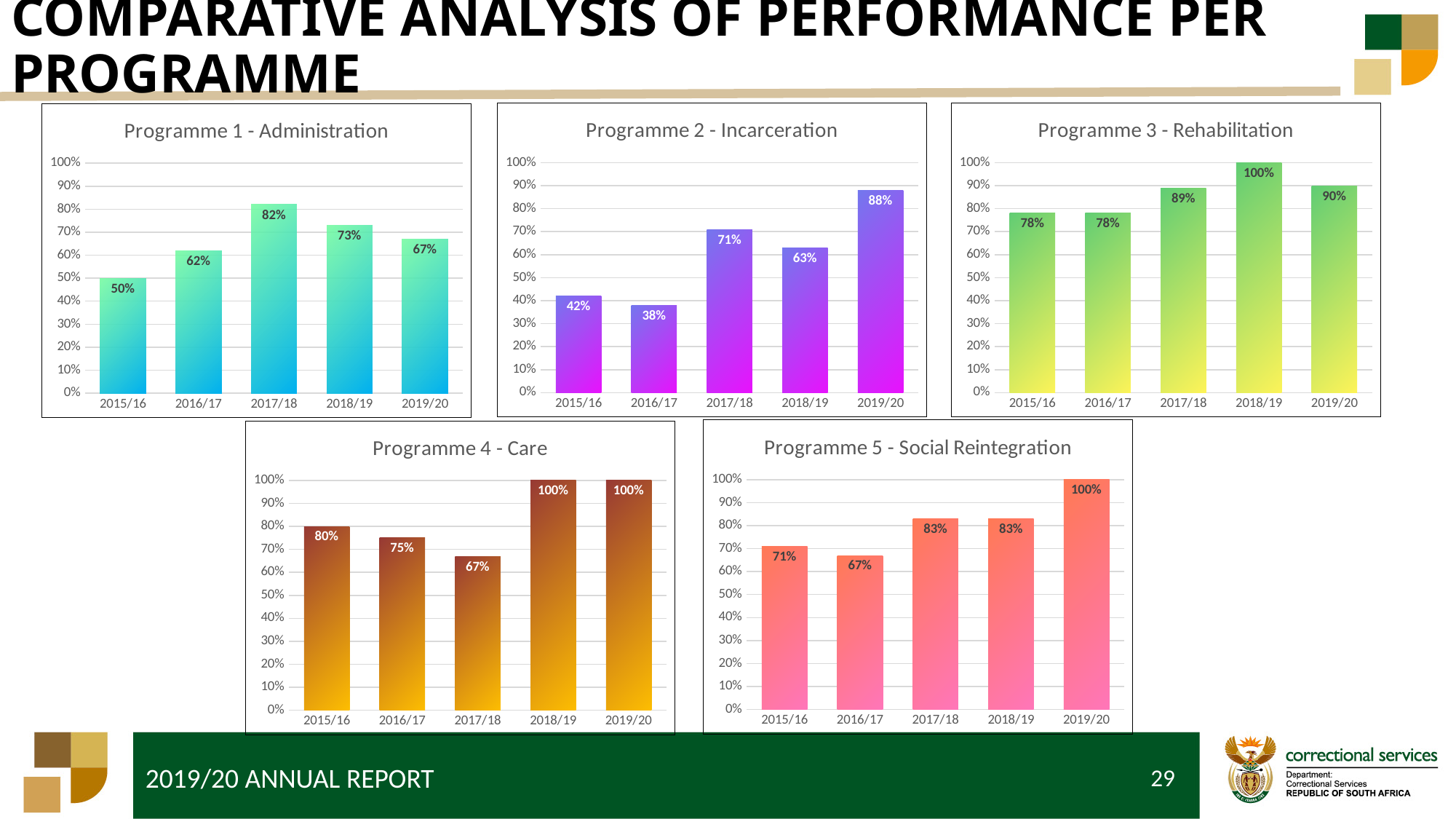
How many bars are in the Programme 1 - Administration chart? 5 In the Programme 4 - Care chart, which is larger, the value for 2015/16 or the value for 2017/18? 2015/16 In the Programme 5 - Social Reintegration chart, what is the difference between the 2019/20 and 2016/17 values? 33% In the Programme 2 - Incarceration chart, which year has the lowest value? 2016/17 What type of chart is the Programme 5 - Social Reintegration chart? Bar chart In the Programme 5 - Social Reintegration chart, what is the value for 2017/18? 83% How many charts are shown on the slide? 5 In the Programme 3 - Rehabilitation chart, what is the value for 2019/20? 90% In the Programme 4 - Care chart, what is the value for 2016/17? 75% In the Programme 2 - Incarceration chart, what is the difference between the 2019/20 and 2015/16 values? 46% In the Programme 1 - Administration chart, what is the value for 2017/18? 82% In the Programme 3 - Rehabilitation chart, which year has the highest value? 2018/19